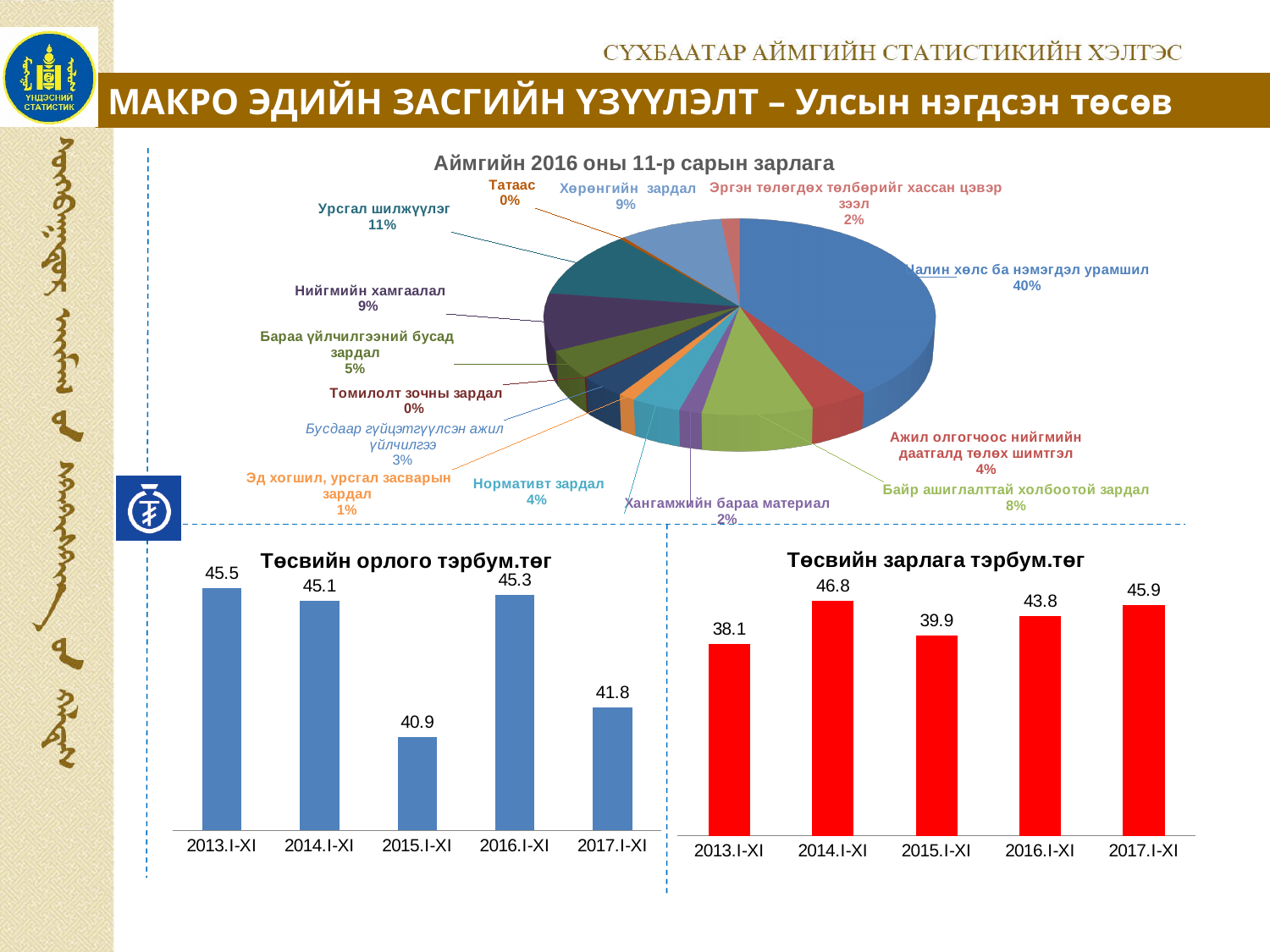
In the 'Төсвийн зарлага тэрбум.төг' chart, what is the difference between the values for 2014.I-XI and 2013.I-XI? 8.7 In the 'Төсвийн зарлага тэрбум.төг' chart, what is the value for 2016.I-XI? 43.8 In the pie chart 'Аймгийн 2016 оны 11-р сарын зарлага', what share does 'Урсгал шилжүүлэг' have? 11% What type of chart is 'Аймгийн 2016 оны 11-р сарын зарлага'? Pie chart In the pie chart 'Аймгийн 2016 оны 11-р сарын зарлага', what share does 'Цалин хөлс ба нэмэгдэл урамшил' have? 40% In the 'Төсвийн зарлага тэрбум.төг' chart, which is larger, the value for 2014.I-XI or 2017.I-XI? 2014.I-XI In the 'Төсвийн зарлага тэрбум.төг' chart, which period has the lowest value? 2013.I-XI In the 'Төсвийн орлого тэрбум.төг' chart, what is the value for 2015.I-XI? 40.9 In the 'Төсвийн орлого тэрбум.төг' chart, which period has the highest value? 2013.I-XI How many periods are shown in the 'Төсвийн зарлага тэрбум.төг' chart? 5 In the 'Төсвийн орлого тэрбум.төг' chart, what is the difference between the values for 2016.I-XI and 2017.I-XI? 3.5 What type of chart is 'Төсвийн орлого тэрбум.төг'? Bar chart